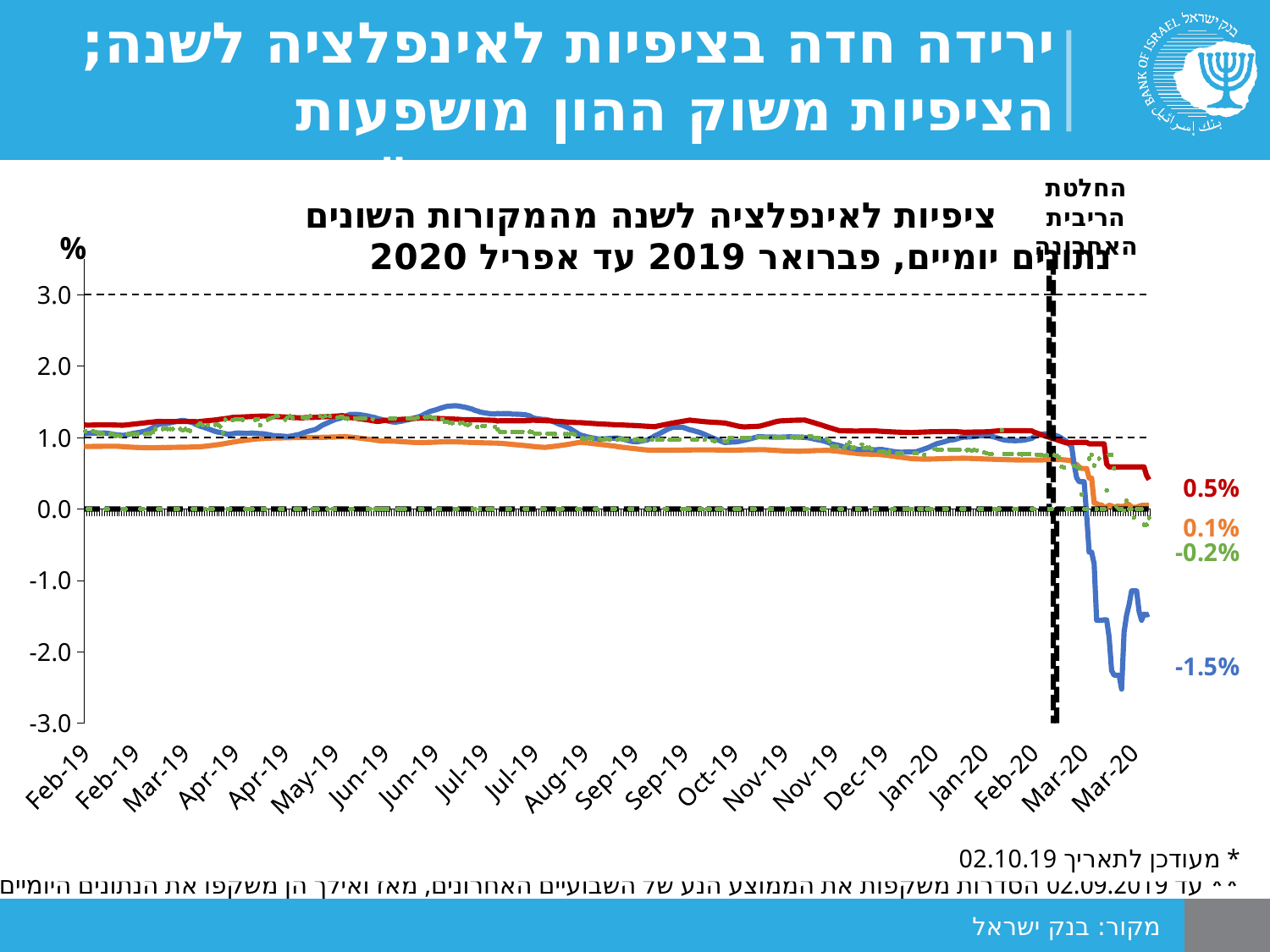
Is the value of the blue line in Mar-20 greater or less than -1.0? less What is the difference between the labelled end values of the red line (0.5%) and the blue line (-1.5%)? 2.0 percentage points What kind of chart is shown on the slide? line chart Which line has the lowest labelled end value? the blue line (-1.5%) What does the vertical dashed black line on the chart mark, according to its label? החלטת הריבית האחרונה Do the lines generally rise or fall from Feb-19 to Mar-20? fall What is the final value labelled for the green dashed line at the right end of the chart? -0.2% What is the final value labelled for the red line at the right end of the chart? 0.5% What is the final value labelled for the blue line at the right end of the chart? -1.5% Is the end value of the red line greater or less than the end value of the orange line? greater What is the final value labelled for the orange line at the right end of the chart? 0.1% Which line has the highest labelled end value? the red line (0.5%)